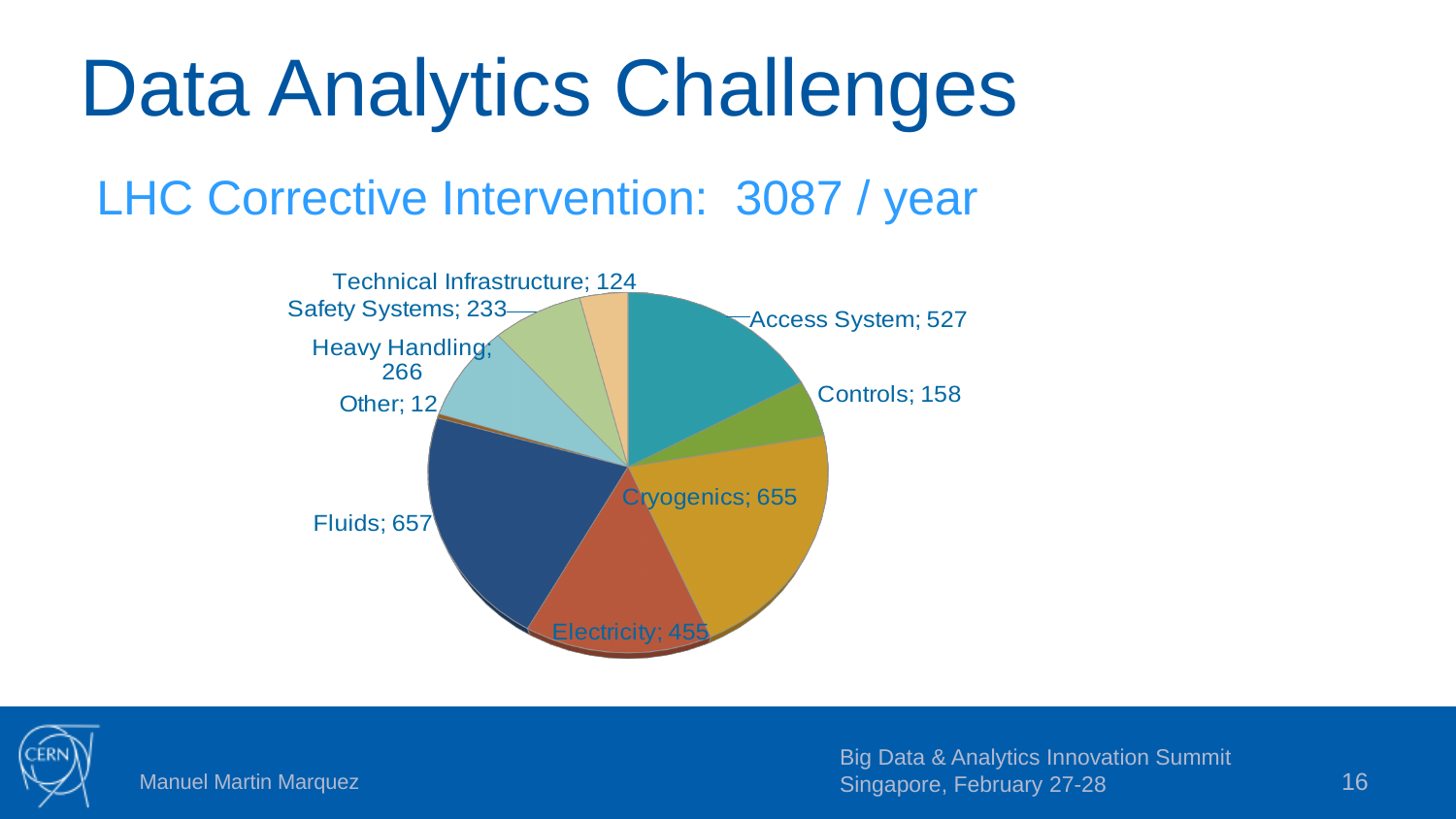
Which is larger, the value for Electricity or the value for Safety Systems? Electricity What is the value for Technical Infrastructure? 124 Which is larger, the value for Controls or the value for Heavy Handling? Heavy Handling What is the difference between the values for Fluids and Cryogenics? 2 What is the value for Heavy Handling? 266 What kind of chart is shown on the slide? Pie chart How many categories are shown in the pie chart? 9 What is the value for Access System? 527 What is the value for Cryogenics? 655 What total number of LHC corrective interventions per year does the slide state? 3087 / year What is the difference between the values for Access System and Controls? 369 Which category has the smallest slice of the pie? Other